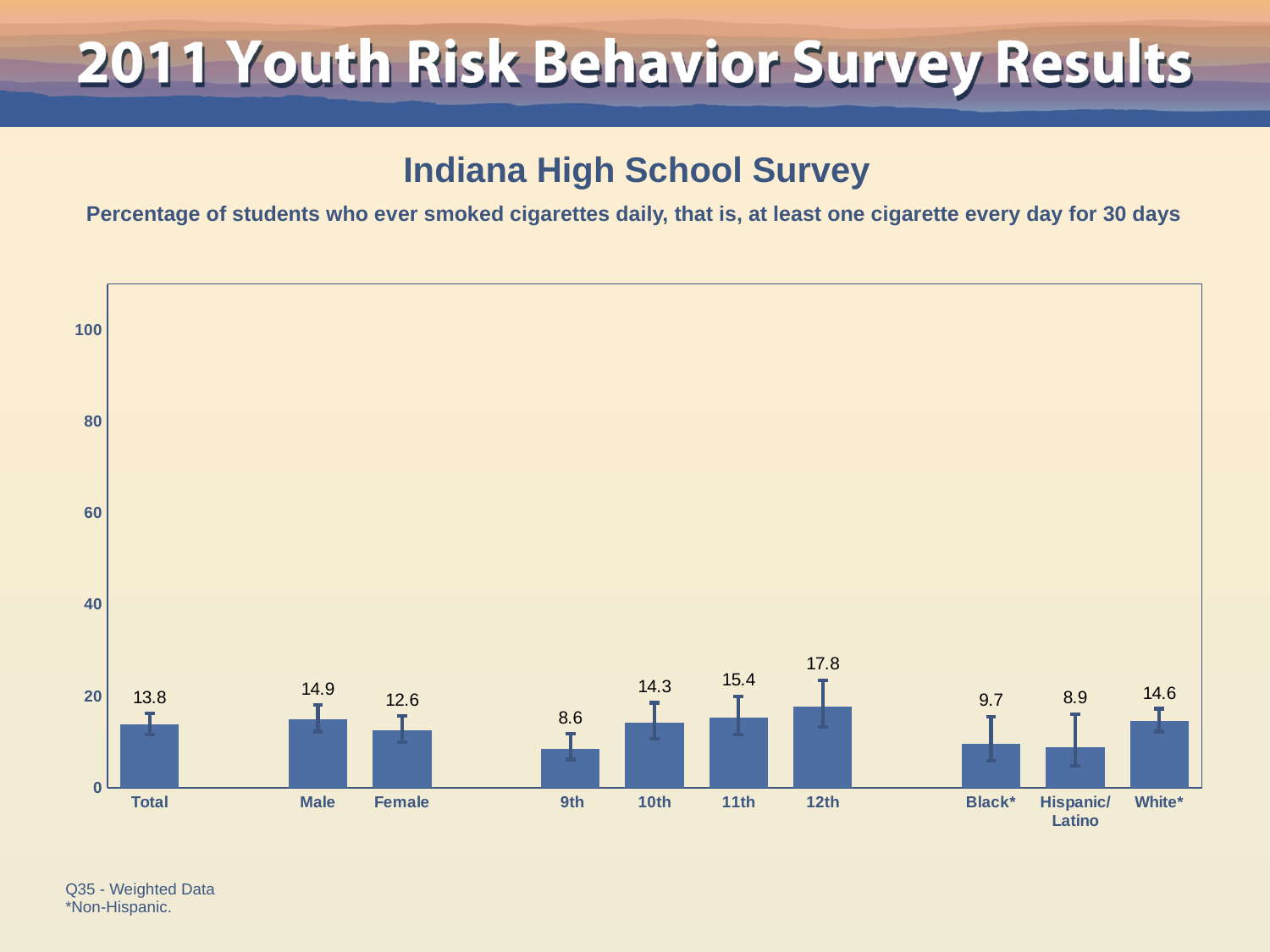
Do the values rise or fall from 9th grade to 12th grade? rise What is the value for 12th grade students? 17.8 How many categories are shown on the x axis? 10 Which category has the lowest value? 9th What is the value for Hispanic/Latino students? 8.9 What is the difference between the values for 12th and 9th grade? 9.2 What is the difference between the values for Male and Female? 2.3 What is the value for Total? 13.8 Is the value for 11th grade greater or less than 20? less What kind of chart is shown on the slide? bar chart Which category has the highest value? 12th Which is larger, the value for Black* or the value for White*? White*